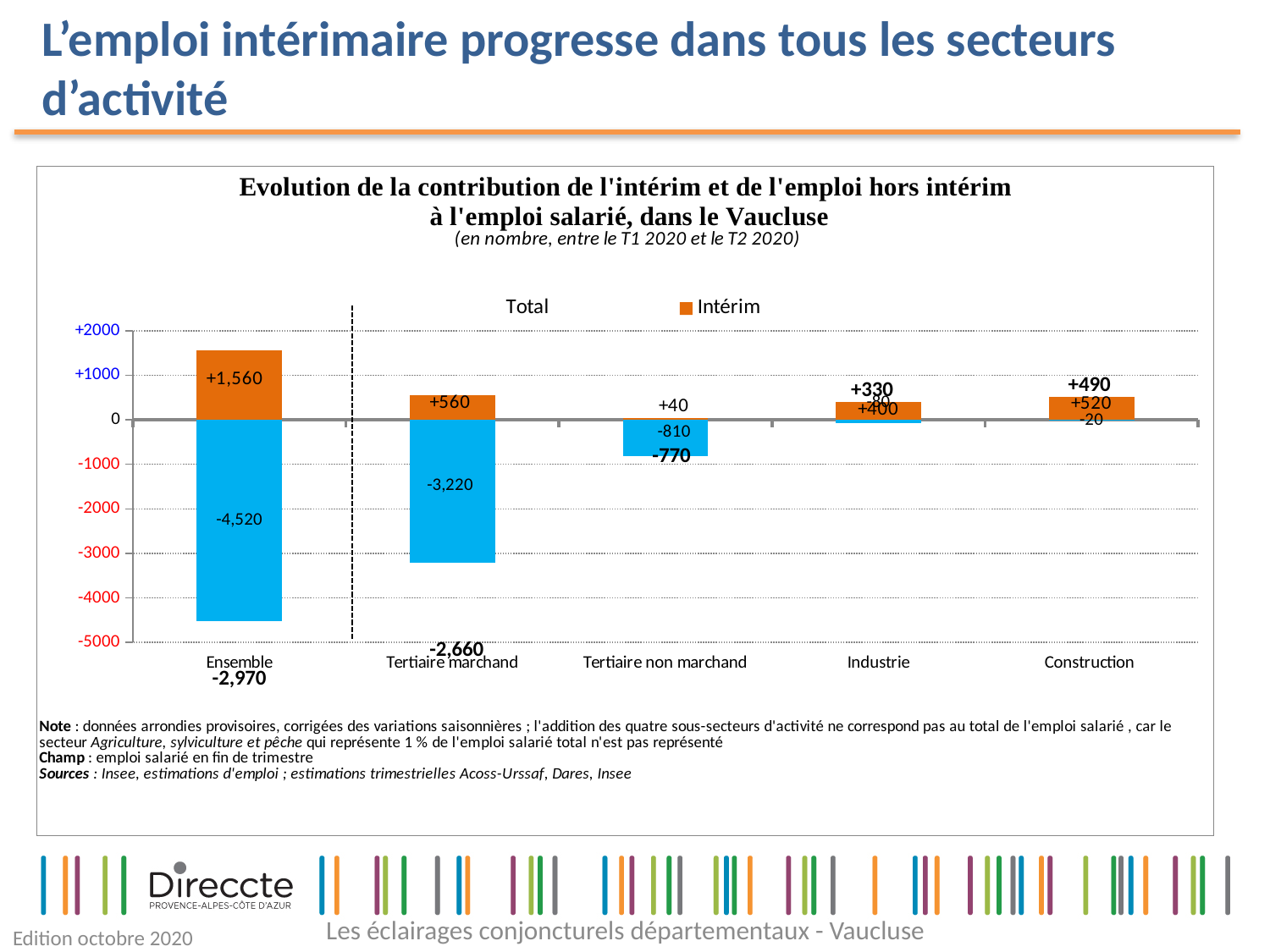
What is the Intérim value for Tertiaire non marchand? +40 What is the Intérim value for Ensemble? +1,560 Which category has the lowest blue bar value? Ensemble How many categories are shown on the x axis? 5 What is the Intérim value for Construction? +520 What is the total shown for Ensemble? -2,970 What is the total shown for Tertiaire marchand? -2,660 What is the total shown for Tertiaire non marchand? -770 What is the value of the blue bar for Tertiaire marchand? -3,220 Which category has the highest Intérim value? Ensemble What kind of chart is this? Bar chart What is the difference between the Intérim value for Ensemble and the Intérim value for Tertiaire marchand? 1,000